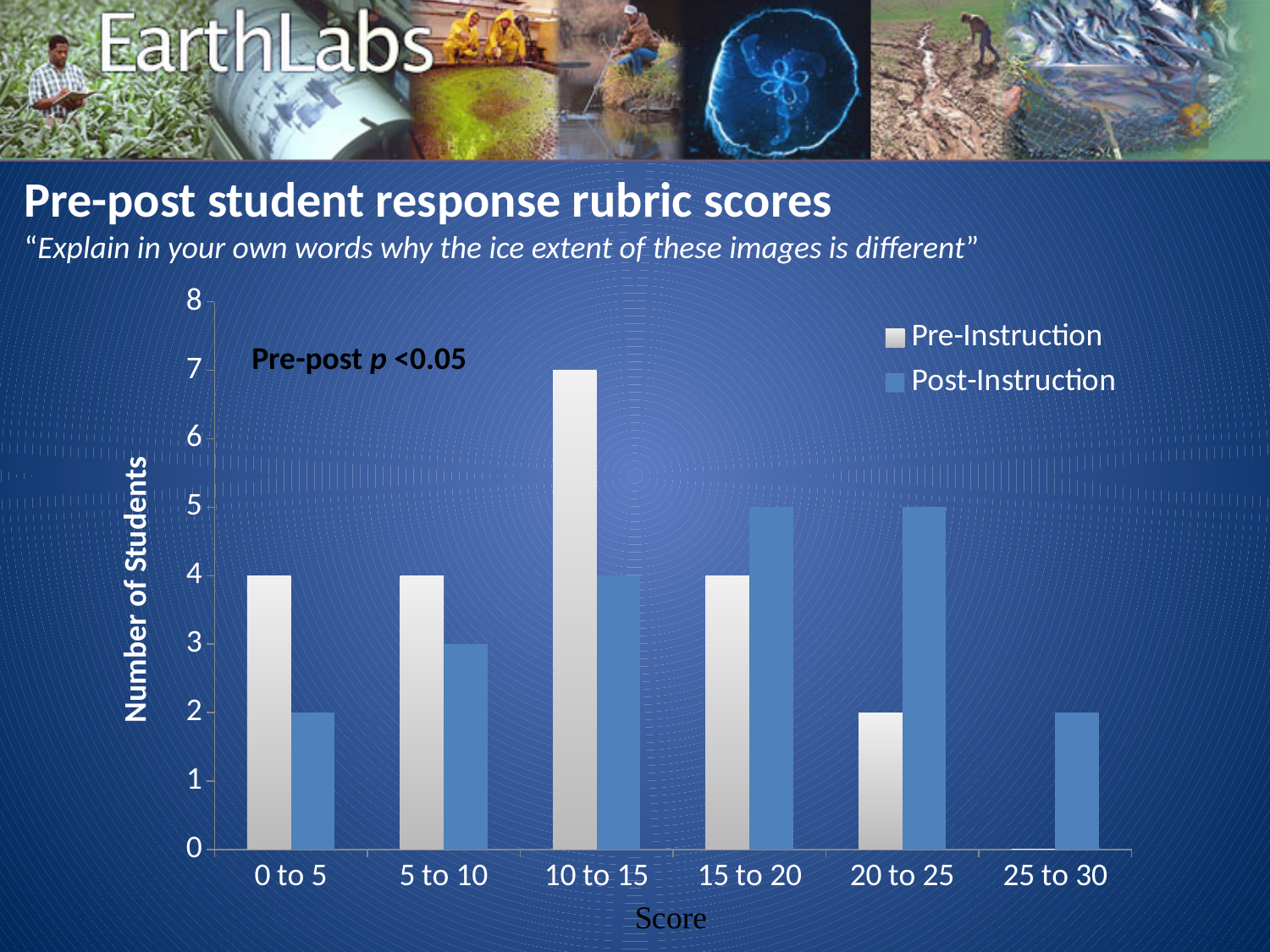
What is the Post-Instruction number of students for the 15 to 20 score range? 5 How many series does the legend list? 2 What is the label of the y axis? Number of Students For the 20 to 25 score range, which series has more students, Pre-Instruction or Post-Instruction? Post-Instruction What kind of chart is shown on the slide? bar chart Which score range has the lowest Post-Instruction number of students? 0 to 5 and 25 to 30 (tied at 2) What is the Post-Instruction number of students for the 25 to 30 score range? 2 Which score range has the highest Pre-Instruction number of students? 10 to 15 What is the difference between the Pre-Instruction and Post-Instruction number of students for the 10 to 15 score range? 3 How many score categories are shown on the x axis? 6 What is the Pre-Instruction number of students for the 10 to 15 score range? 7 What p-value annotation is shown on the chart? Pre-post p <0.05